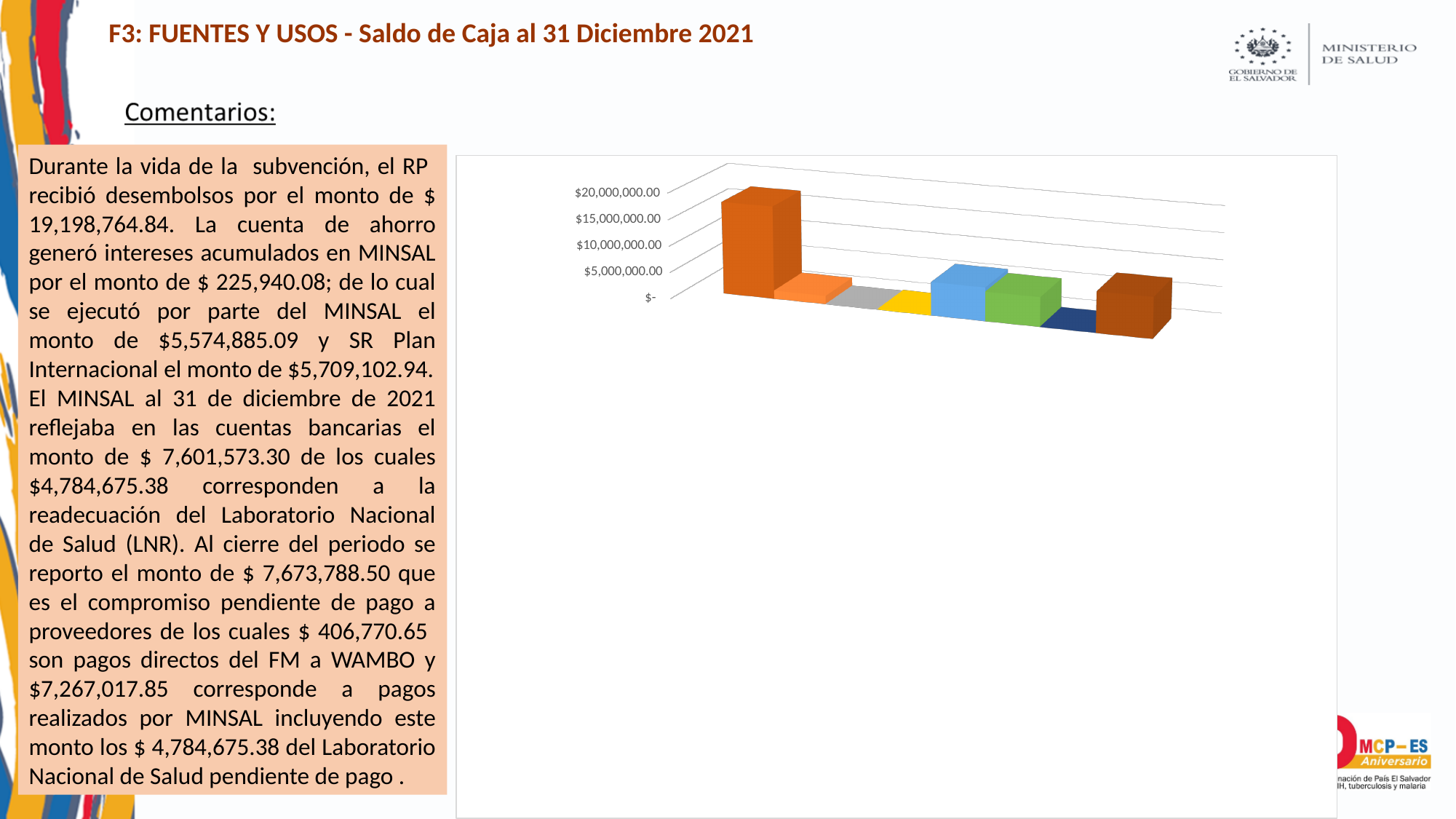
What kind of chart is shown on the slide? bar chart Which bar is the highest in the chart? the leftmost (dark orange) bar Is the value of the leftmost bar greater or less than $15,000,000.00? greater Which is larger, the light blue bar or the gray bar? the light blue bar How many bars are plotted in the chart? 8 Is the value of the light blue bar greater or less than $10,000,000.00? less What is the lowest tick label shown on the vertical axis? $- Is the value of the rightmost (brown) bar greater or less than $10,000,000.00? less Which is larger, the leftmost bar or the rightmost bar? the leftmost bar What is the highest tick label shown on the vertical axis? $20,000,000.00